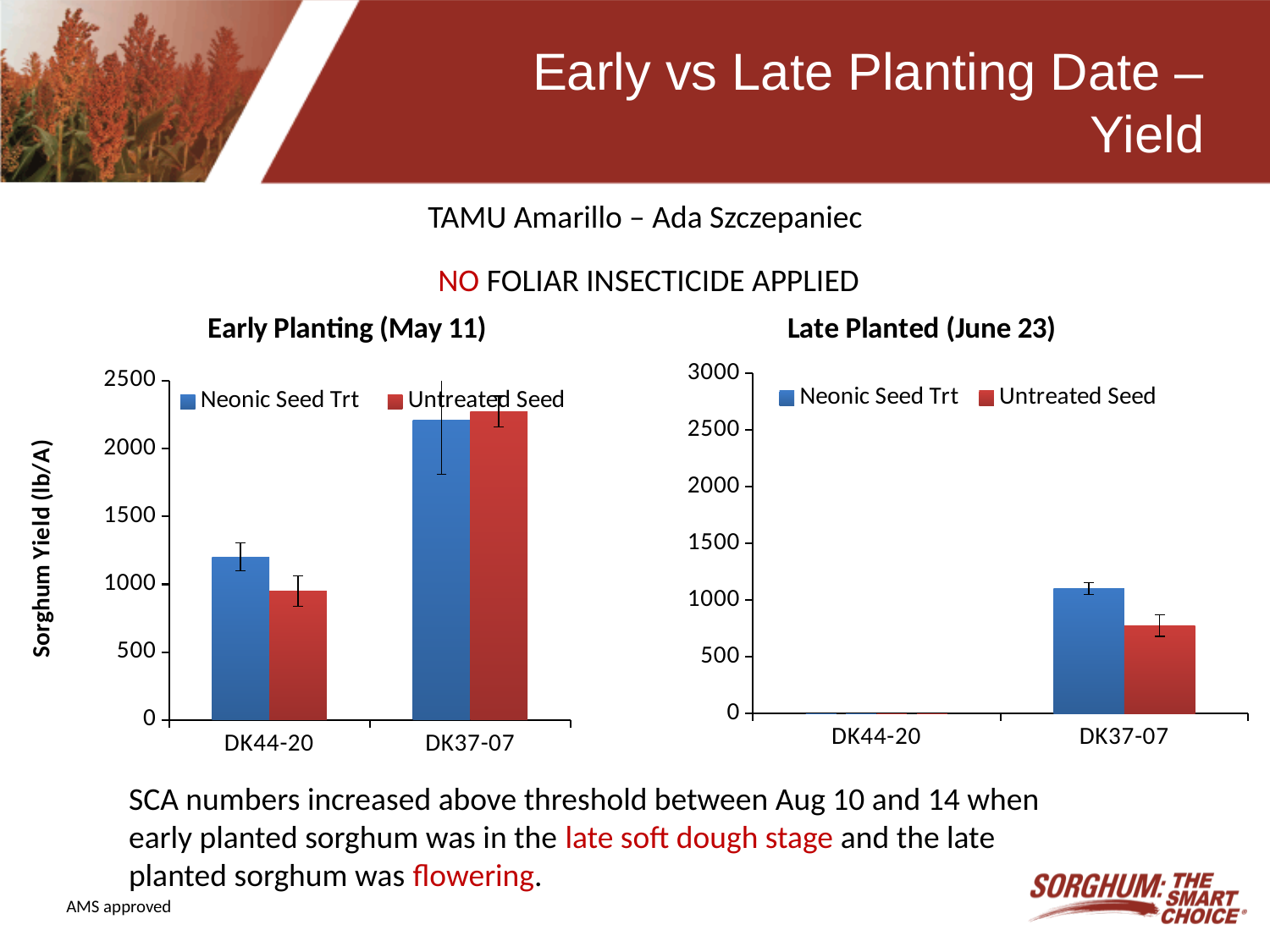
What kind of chart is the Early Planting (May 11) chart? bar chart In the Late Planted (June 23) chart, which series has the larger value for DK37-07, Neonic Seed Trt or Untreated Seed? Neonic Seed Trt In the Late Planted (June 23) chart, is the Untreated Seed value for DK37-07 greater or less than 1000? less In the Early Planting (May 11) chart, which hybrid has the higher Neonic Seed Trt yield? DK37-07 In the Late Planted (June 23) chart, is the Neonic Seed Trt value for DK37-07 greater or less than 1000? greater How many hybrid categories are shown on the x axis of the Early Planting (May 11) chart? 2 In the Early Planting (May 11) chart, which series has the larger value for DK44-20, Neonic Seed Trt or Untreated Seed? Neonic Seed Trt What is the y-axis label of the Early Planting (May 11) chart? Sorghum Yield (lb/A) In the Early Planting (May 11) chart, is the Neonic Seed Trt value for DK37-07 greater or less than 2000? greater In the Late Planted (June 23) chart, what colour represents the Untreated Seed series? red How many series does the legend of the Late Planted (June 23) chart list? 2